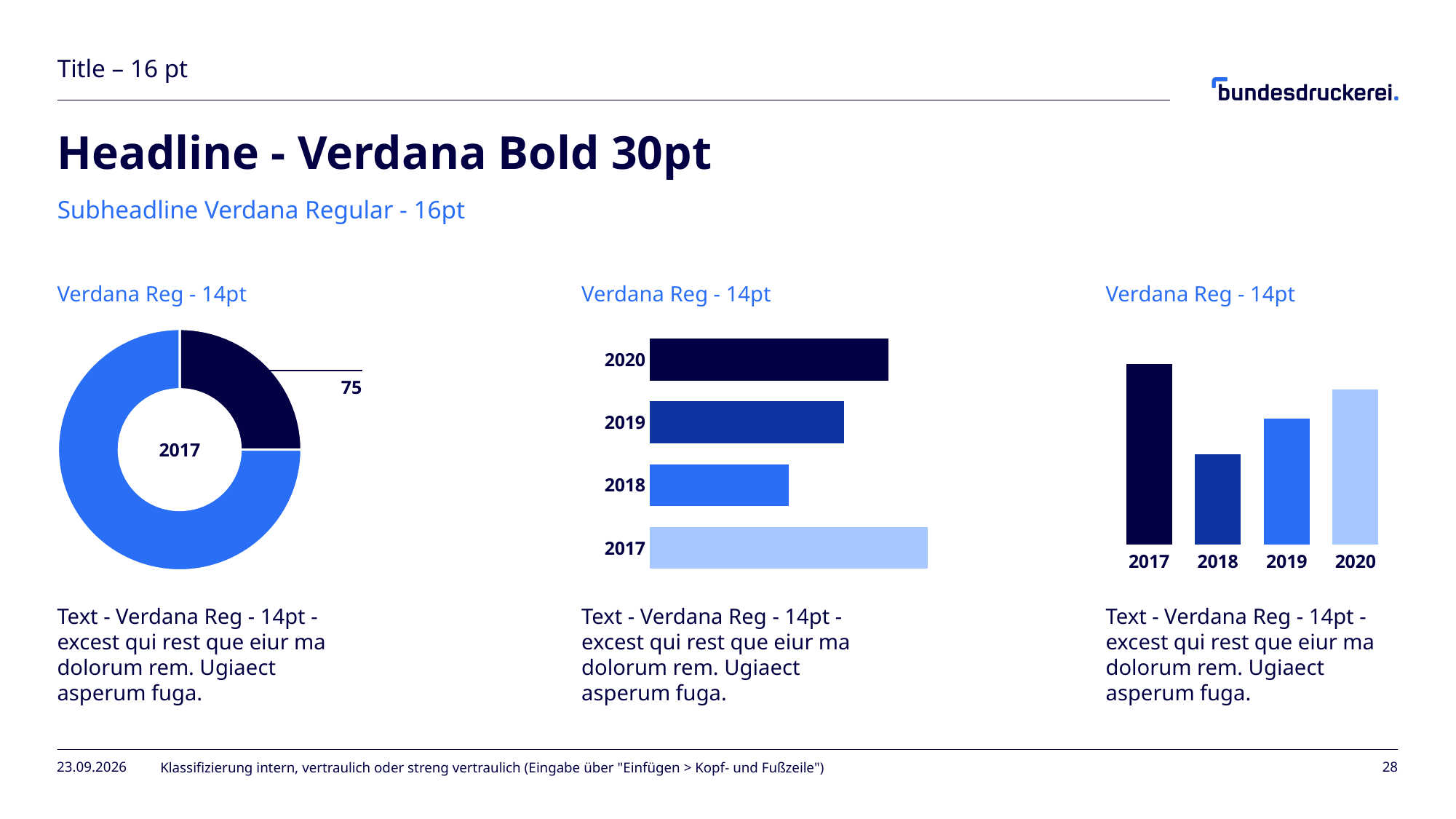
In the middle bar chart, which bar is longer, 2020 or 2019? 2020 In the right bar chart, how many bars are there? 4 What kind of chart is the middle chart on the slide? Bar chart In the right bar chart, which year has the shortest bar? 2018 In the right bar chart, which year has the tallest bar? 2017 What kind of chart is the left chart on the slide? Donut chart What kind of chart is the right chart on the slide? Bar chart In the middle bar chart, which year has the longest bar? 2017 In the middle bar chart, which year has the shortest bar? 2018 In the left donut chart, what data label is shown next to the dark slice? 75 In the right bar chart, which bar is taller, 2019 or 2018? 2019 In the middle bar chart, how many categories are plotted? 4